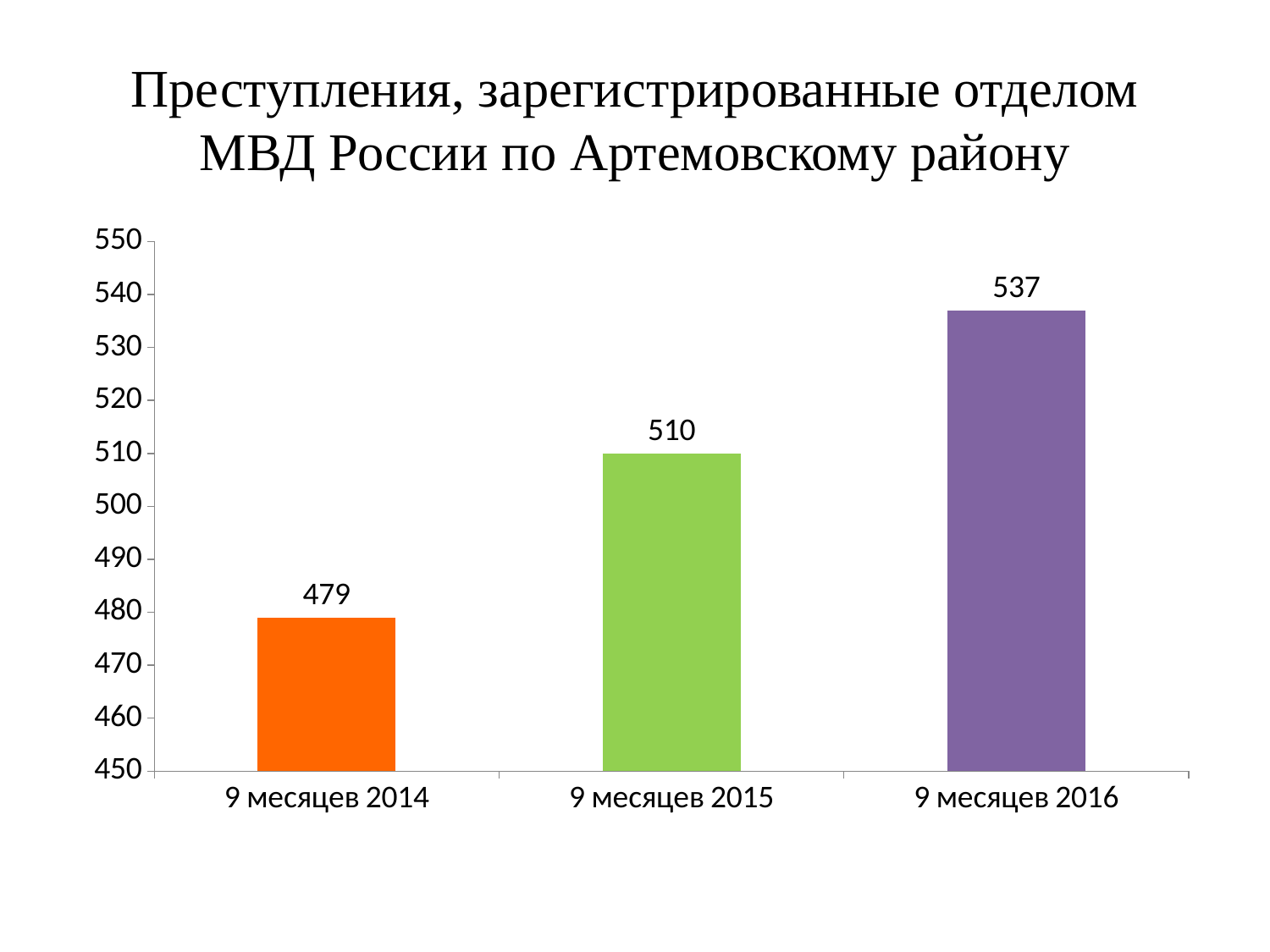
What kind of chart is shown on the slide? bar chart Which category has the highest value? 9 месяцев 2016 What is the value for 9 месяцев 2016? 537 Do the values rise or fall from 9 месяцев 2014 to 9 месяцев 2016? rise Which is larger, the value for 9 месяцев 2015 or the value for 9 месяцев 2016? 9 месяцев 2016 Which category has the lowest value? 9 месяцев 2014 What is the value for 9 месяцев 2015? 510 How many categories are shown on the x axis? 3 Is the value for 9 месяцев 2014 greater or less than 500? less What is the difference between the values for 9 месяцев 2016 and 9 месяцев 2014? 58 What is the difference between the values for 9 месяцев 2015 and 9 месяцев 2014? 31 What is the value for 9 месяцев 2014? 479